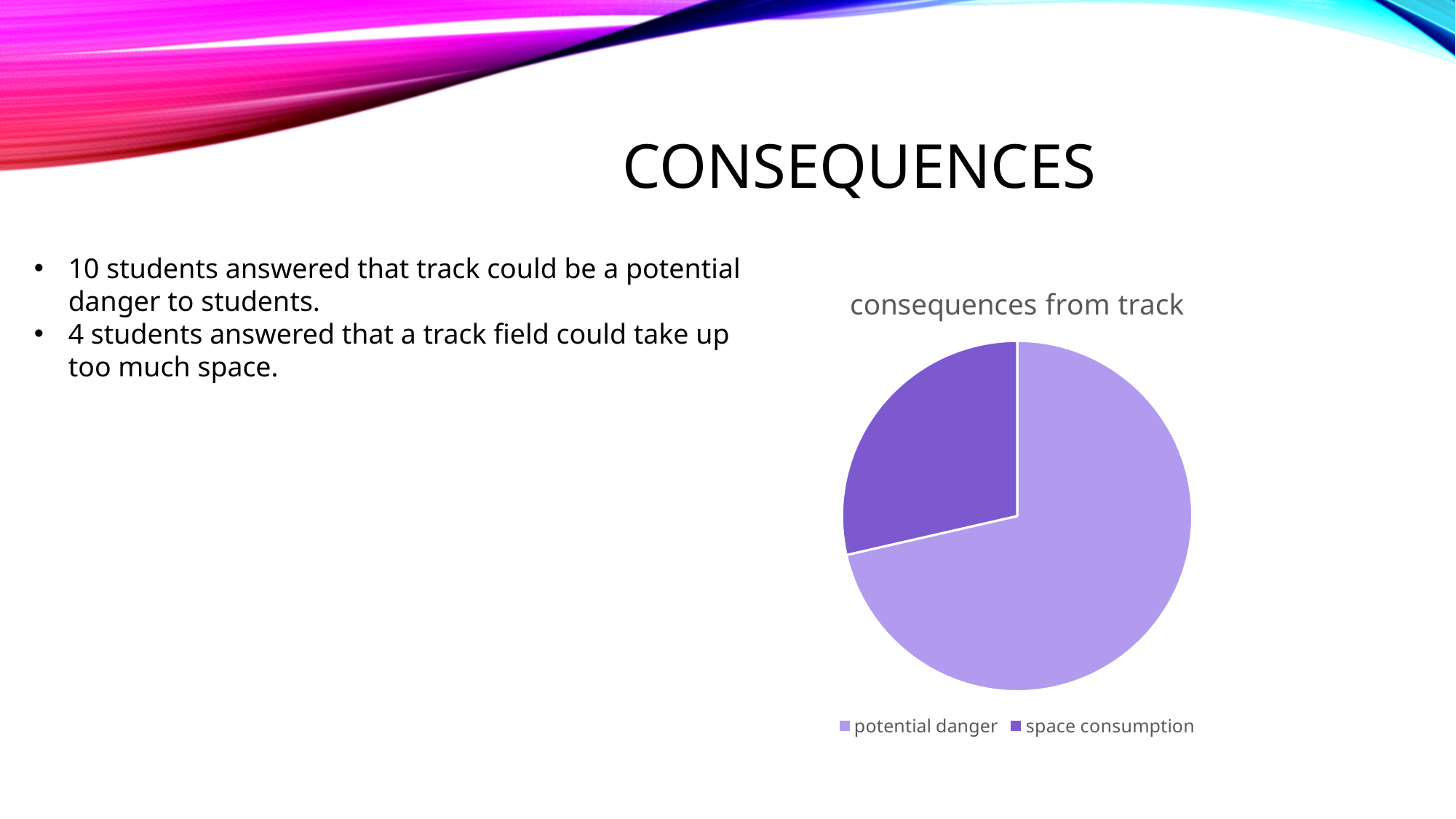
Which category has the smallest slice of the pie? space consumption How many slices does the pie chart have? 2 Which slice is larger, potential danger or space consumption? potential danger Which category has the largest slice of the pie? potential danger What kind of chart is shown on the slide? pie chart What is the title of the chart? consequences from track What are the two categories listed in the chart legend? potential danger, space consumption How many entries does the chart legend list? 2 Does the potential danger slice take up more or less than half of the pie? more